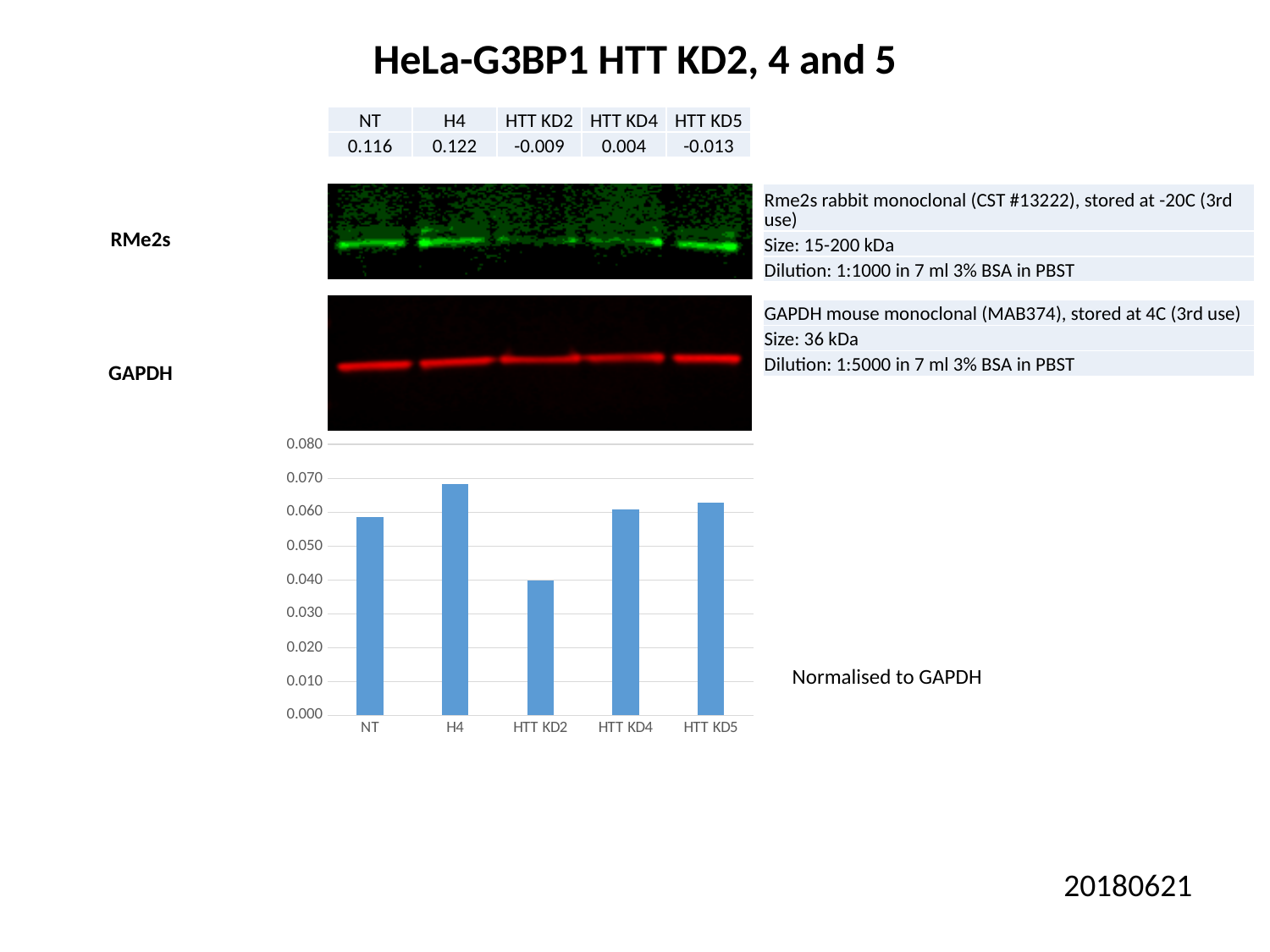
Is the value for HTT KD2 greater or less than 0.050? less Is the value for H4 greater or less than 0.060? greater How many categories are plotted on the bar chart? 5 Which category has the highest bar in the chart? H4 Is the value for HTT KD4 greater or less than 0.070? less According to the text next to the chart, what are the plotted values normalised to? GAPDH Which bar is taller, NT or HTT KD2? NT What is the highest value shown on the chart's vertical axis? 0.080 Which category has the lowest bar in the chart? HTT KD2 Which bar is taller, H4 or HTT KD2? H4 What kind of chart is shown on the slide? bar chart